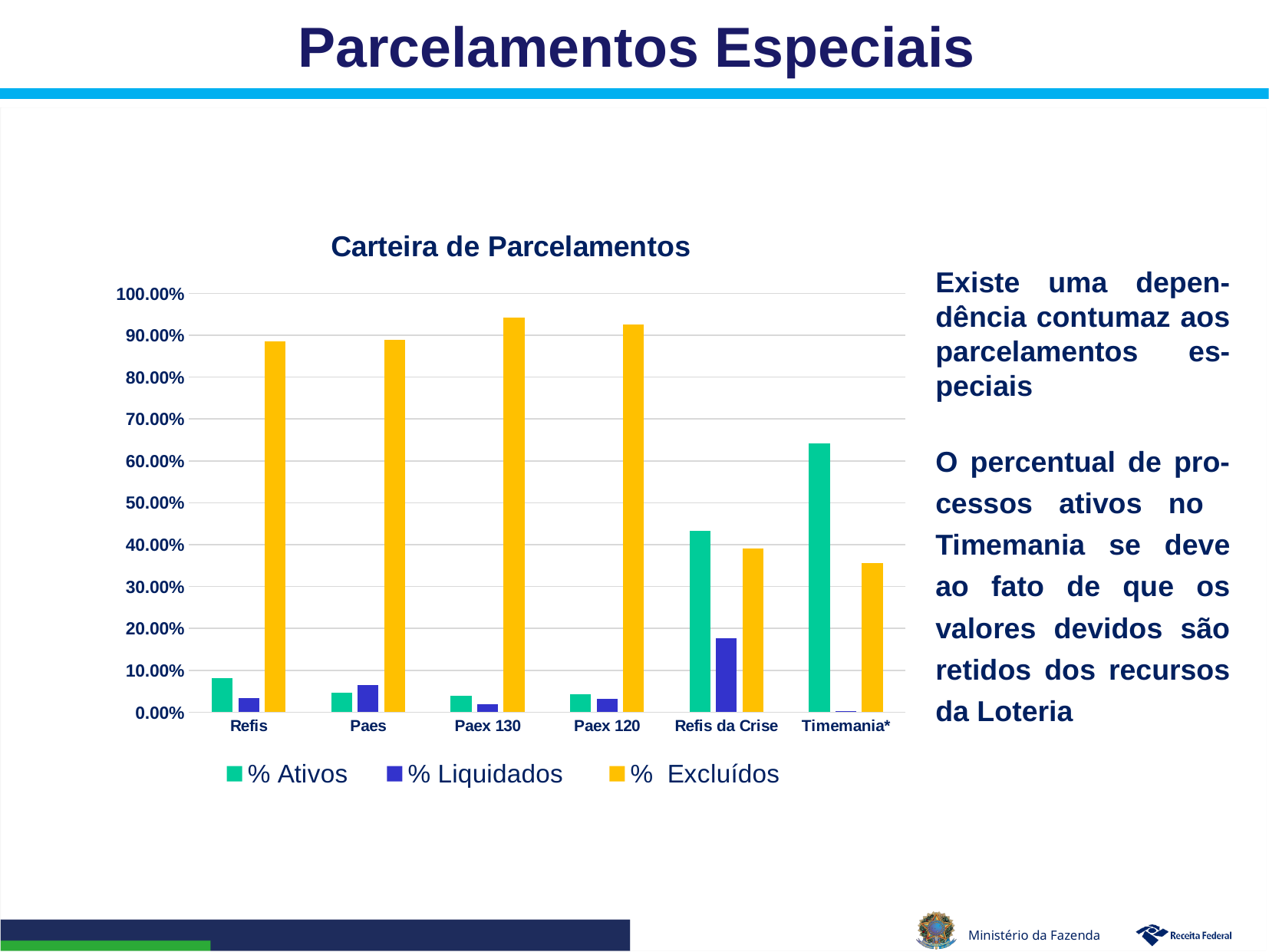
Is the '% Excluídos' value for Paex 130 greater or less than 90.00%? greater Is the '% Ativos' value for Timemania* greater or less than 60.00%? greater Is the '% Excluídos' value for Refis greater or less than 80.00%? greater Which category has the highest '% Liquidados' value? Refis da Crise Which category has the lowest '% Excluídos' value? Timemania* What kind of chart is 'Carteira de Parcelamentos'? bar chart For Timemania*, which is larger: '% Ativos' or '% Excluídos'? % Ativos How many categories are shown on the x axis of the 'Carteira de Parcelamentos' chart? 6 Which category has the highest '% Ativos' value? Timemania* Which series in the 'Carteira de Parcelamentos' chart is shown in yellow? % Excluídos How many series does the legend of the 'Carteira de Parcelamentos' chart list? 3